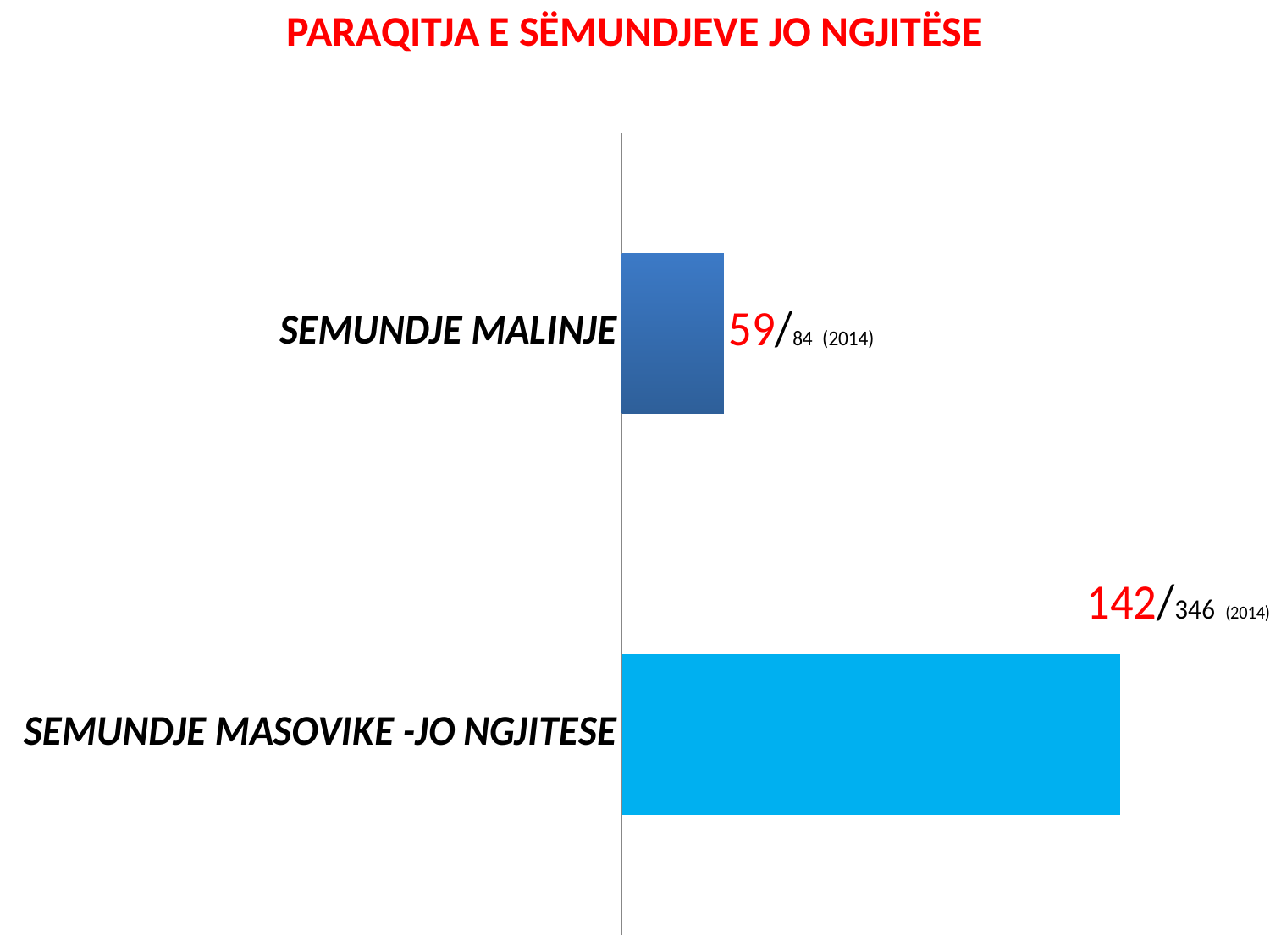
What is the title of the chart? PARAQITJA E SËMUNDJEVE JO NGJITËSE What type of chart is shown on the slide? bar chart Which is larger: the current value for SEMUNDJE MALINJE or for SEMUNDJE MASOVIKE -JO NGJITESE? SEMUNDJE MASOVIKE -JO NGJITESE What is the current value shown for SEMUNDJE MALINJE? 59 How many categories are plotted in the chart? 2 Which category has the shortest bar? SEMUNDJE MALINJE What is the current value shown for SEMUNDJE MASOVIKE -JO NGJITESE? 142 What was the 2014 value shown for SEMUNDJE MALINJE? 84 What is the difference between the current values for SEMUNDJE MASOVIKE -JO NGJITESE and SEMUNDJE MALINJE? 83 What is the difference between the 2014 value and the current value for SEMUNDJE MASOVIKE -JO NGJITESE? 204 Which category has the longest bar? SEMUNDJE MASOVIKE -JO NGJITESE What was the 2014 value shown for SEMUNDJE MASOVIKE -JO NGJITESE? 346